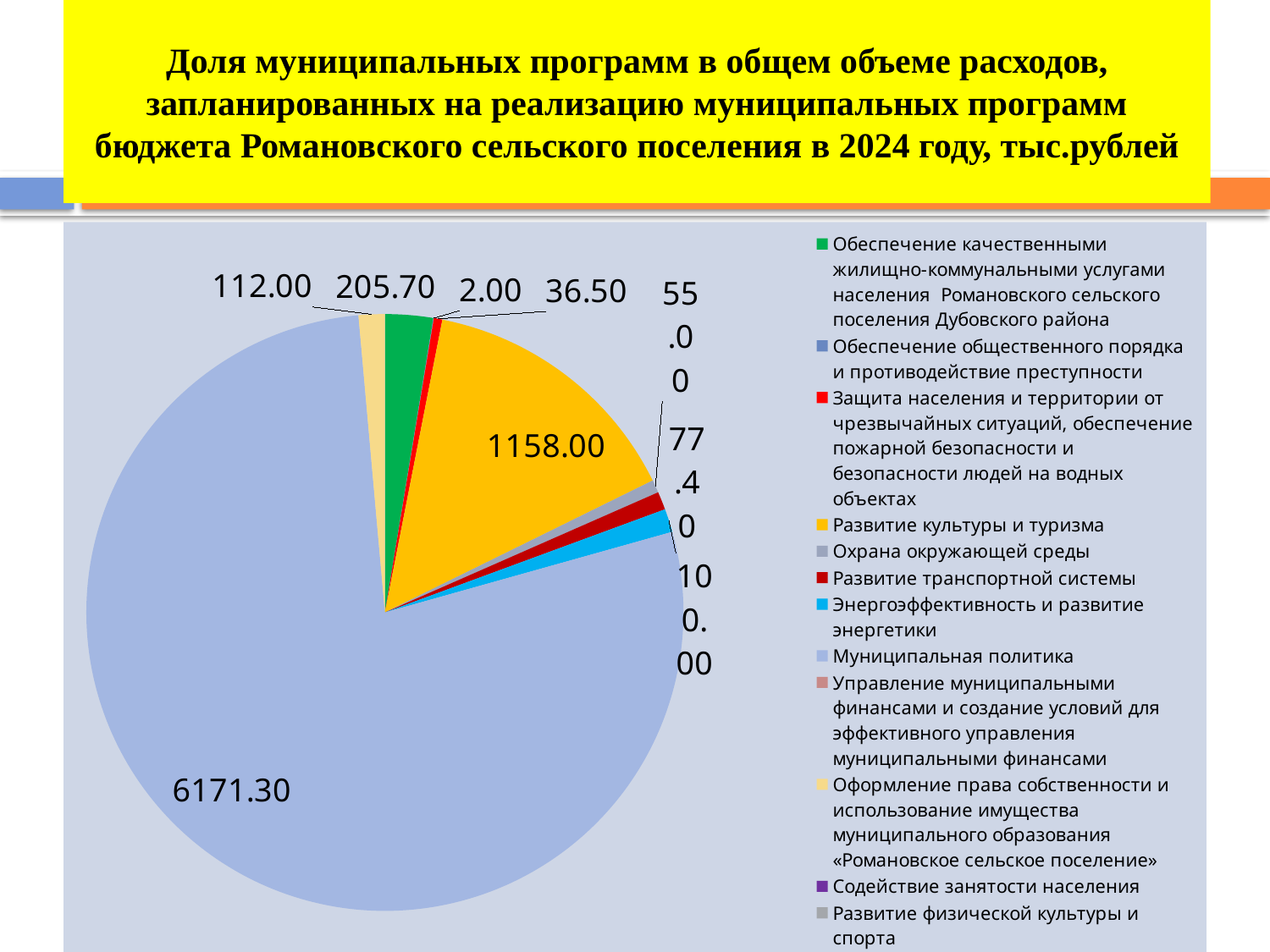
Which is larger: the slice labelled 77.40 or the slice labelled 100.00? 100.00 Which legend category corresponds to the largest slice (6171.30)? Муниципальная политика What is the difference between the slices labelled 205.70 and 112.00? 93.70 How many categories does the legend list? 12 What is the value shown for the green slice, Обеспечение качественными жилищно-коммунальными услугами населения? 205.70 What is the smallest value labelled on the pie chart? 2.00 Which is larger: the slice for Развитие культуры и туризма or the slice for Муниципальная политика? Муниципальная политика What is the value of the largest slice in the pie chart? 6171.30 What is the difference between the largest slice (6171.30) and the slice labelled 1158.00? 5013.30 What unit of measurement is stated in the chart title? тыс.рублей What is the value shown for the yellow slice, Развитие культуры и туризма? 1158.00 What kind of chart is shown on the slide? Pie chart